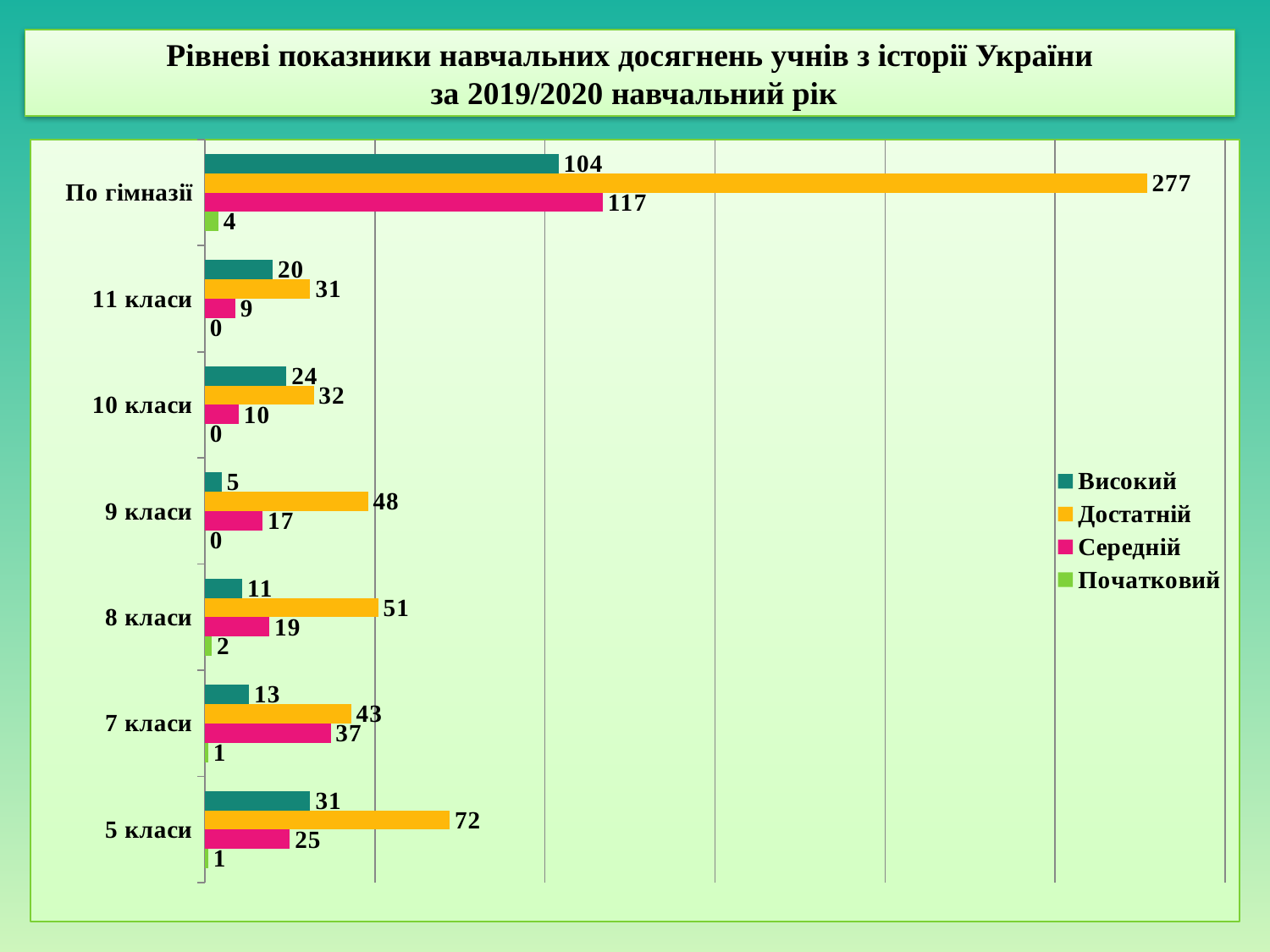
How many series does the legend list? 4 What is the value of Високий for 5 класи? 31 Which series is shown in green in the legend? Початковий What is the value of Початковий for 8 класи? 2 What kind of chart is shown on the slide? bar chart Which is larger for 11 класи: Високий or Середній? Високий What is the difference between the Достатній and Середній values for По гімназії? 160 Which class group has the highest Достатній value (excluding По гімназії)? 5 класи What is the value of Середній for 7 класи? 37 Which class group has the lowest Високий value? 9 класи How many categories are shown on the y axis? 7 What is the value of Достатній for По гімназії? 277